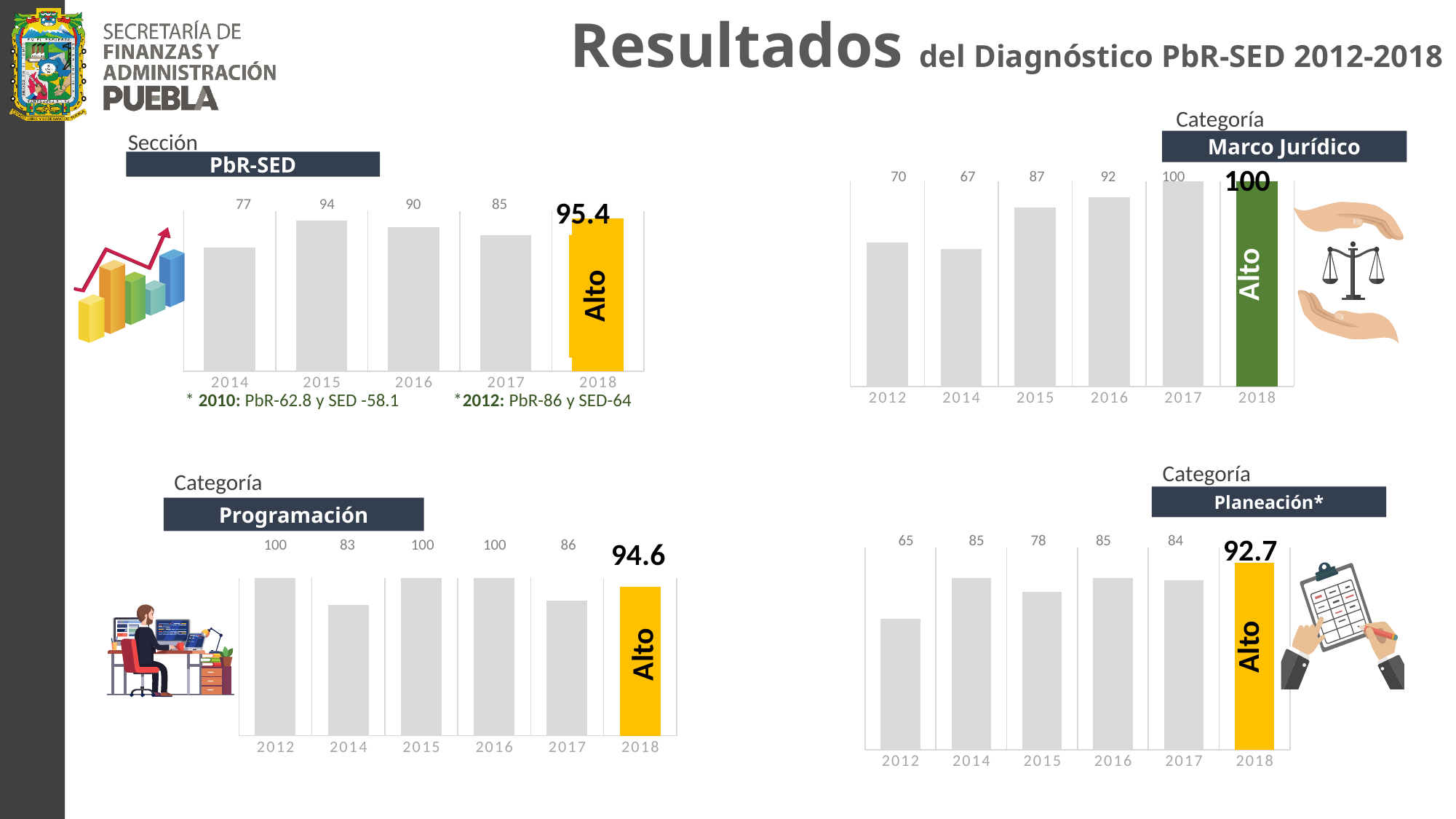
In the Planeación* chart, which year has the highest value? 2018 In the Marco Jurídico chart, is the value for 2016 larger or smaller than the value for 2012? larger How many bars does the PbR-SED chart have? 5 In the Programación chart, what is the value for 2014? 83 In the PbR-SED chart, which year has the lowest value? 2014 In the PbR-SED chart, what is the difference between the 2015 value and the 2017 value? 9 In the Marco Jurídico chart, which year has the lowest value? 2014 In the Marco Jurídico chart, what is the value for 2015? 87 In the Planeación* chart, what is the value for 2012? 65 In the Programación chart, what is the difference between the 2018 value and the 2017 value? 8.6 What type of chart is the Planeación* chart? Bar chart In the PbR-SED chart, what is the value for 2018? 95.4